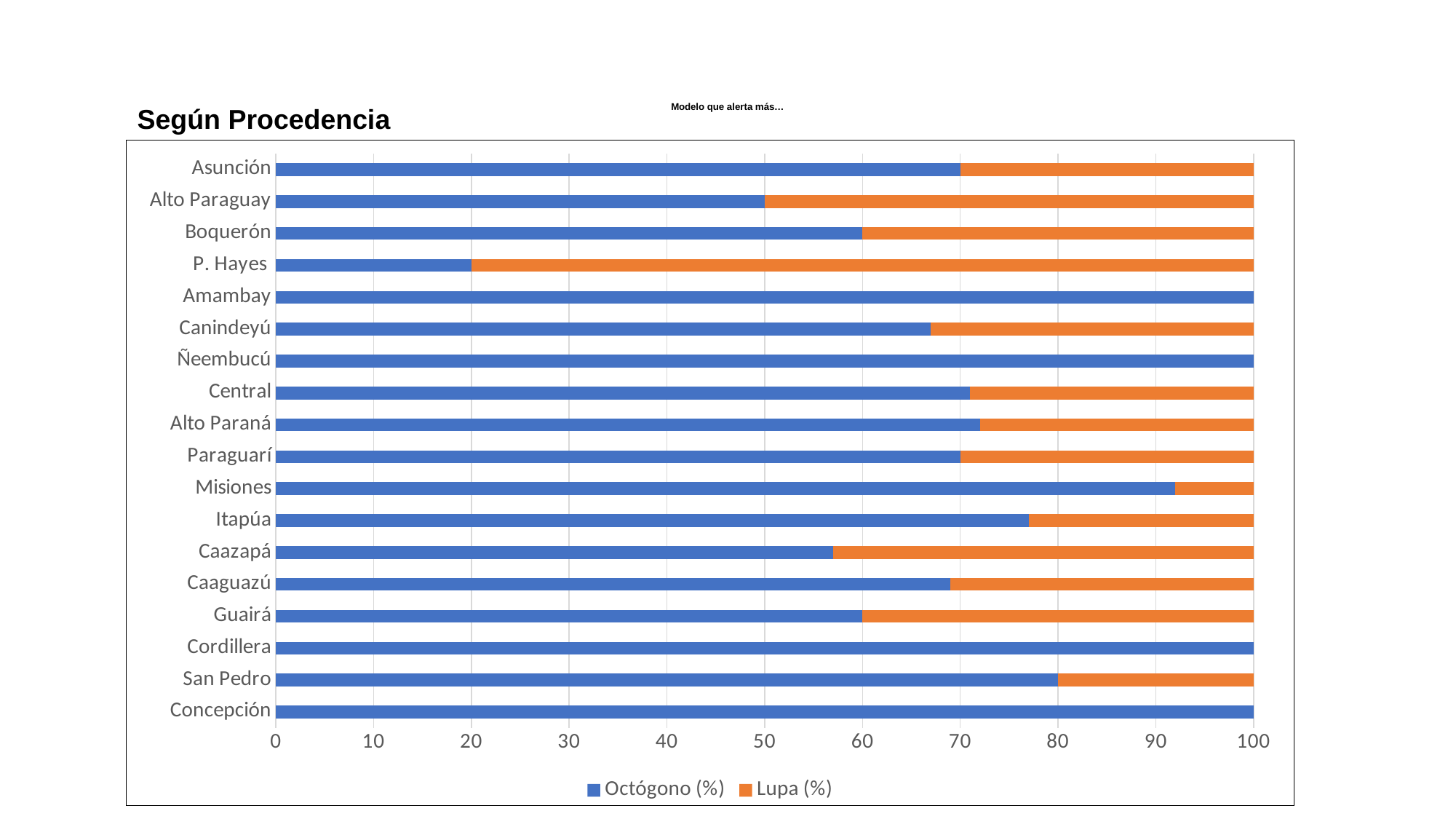
What is the Octógono (%) value for Alto Paraguay? 50 How many series does the legend list? 2 How many categories (departments) are shown on the y axis? 18 What kind of chart is shown on the slide? bar chart What is the Octógono (%) value for P. Hayes? 20 Is the Octógono (%) value for Caazapá greater or less than 60? less Which category has the lowest Octógono (%) value? P. Hayes What are the two series named in the legend? Octógono (%) and Lupa (%) Which has the larger Octógono (%) value, Misiones or Caazapá? Misiones Is the Octógono (%) value for Misiones greater or less than 90? greater Which has the larger Octógono (%) value, Caaguazú or Guairá? Caaguazú What is the Octógono (%) value for San Pedro? 80